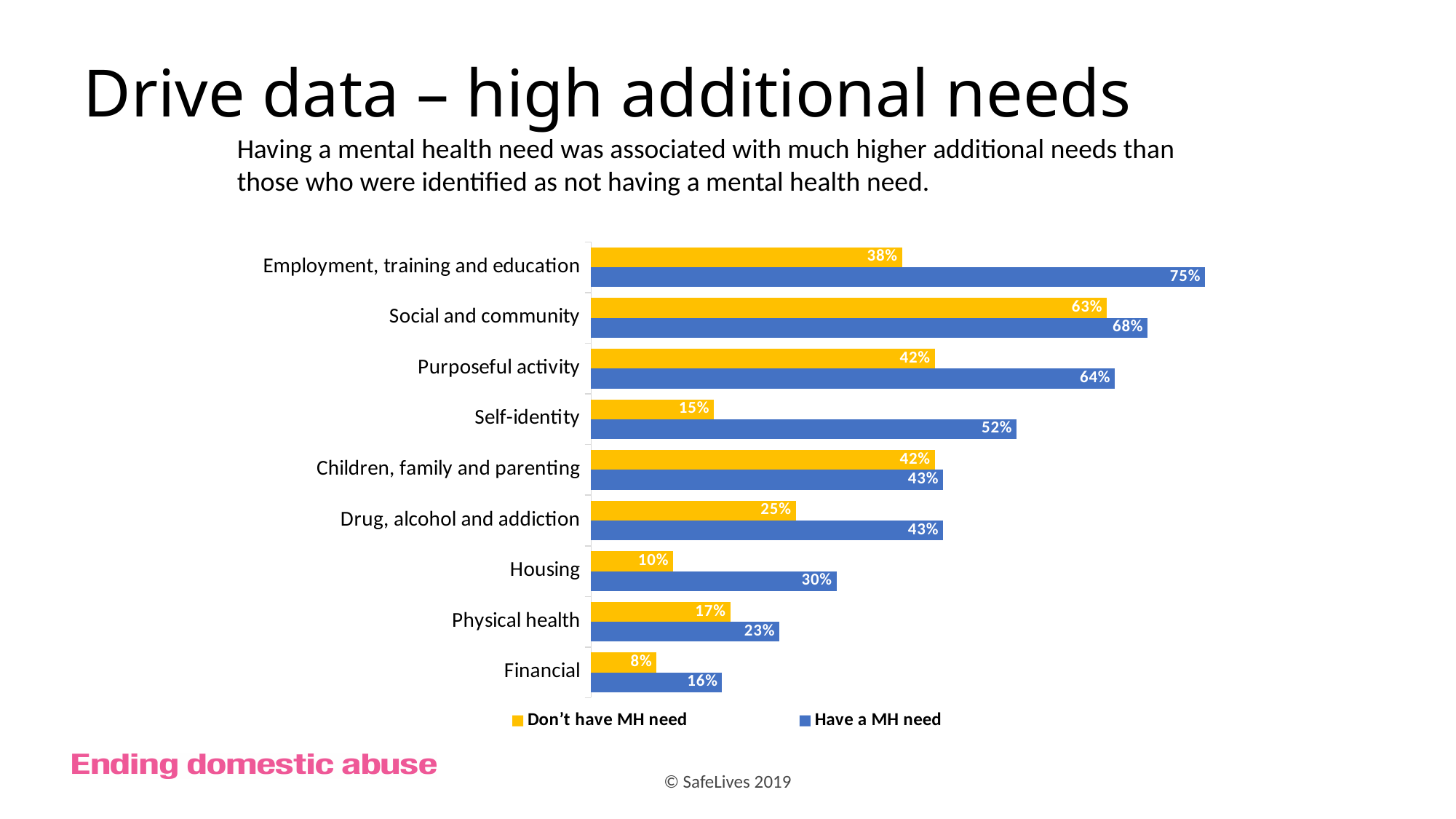
What is the value for 'Have a MH need' in the Employment, training and education category? 75% What kind of chart is shown on the slide? Bar chart Which category has the lowest value for 'Don't have MH need'? Financial Which colour represents the 'Don't have MH need' series? Yellow What is the difference between the 'Have a MH need' and 'Don't have MH need' values for Self-identity? 37% What is the value for 'Don't have MH need' in the Self-identity category? 15% How many series does the legend list? 2 How many categories are shown on the chart? 9 Which category has the highest value for 'Have a MH need'? Employment, training and education What is the difference between the 'Have a MH need' values for Employment, training and education and Financial? 59% What is the value for 'Have a MH need' in the Housing category? 30% Which is larger for Social and community: the 'Have a MH need' value or the 'Don't have MH need' value? Have a MH need